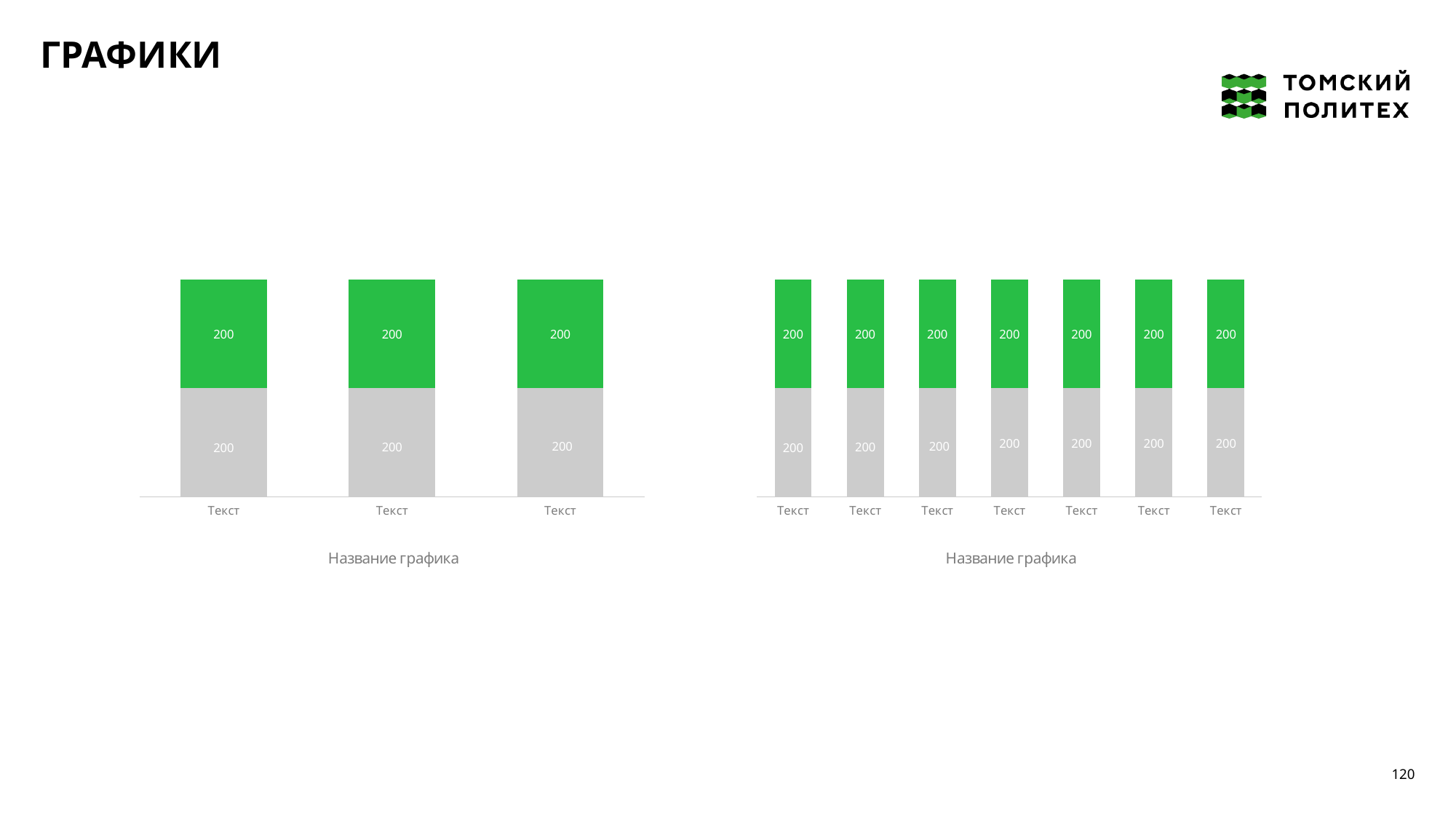
What kind of chart is the right chart on the slide? stacked bar chart What is the title shown under the left chart? Название графика In the left chart, what is the total of the first stacked bar? 400 In the left chart, what is the value of the green segment of the first bar? 200 How many bars does the left chart have? 3 In the right chart, what is the total of the fourth stacked bar? 400 What label is used for every category on the x axis of the right chart? Текст How many bars does the right chart have? 7 In the left chart, what is the value of the grey segment of the third bar? 200 In the right chart, what is the value of the green segment of the last bar? 200 In the right chart, what is the difference between the green and grey segments of the first bar? 0 What kind of chart is the left chart on the slide? stacked bar chart